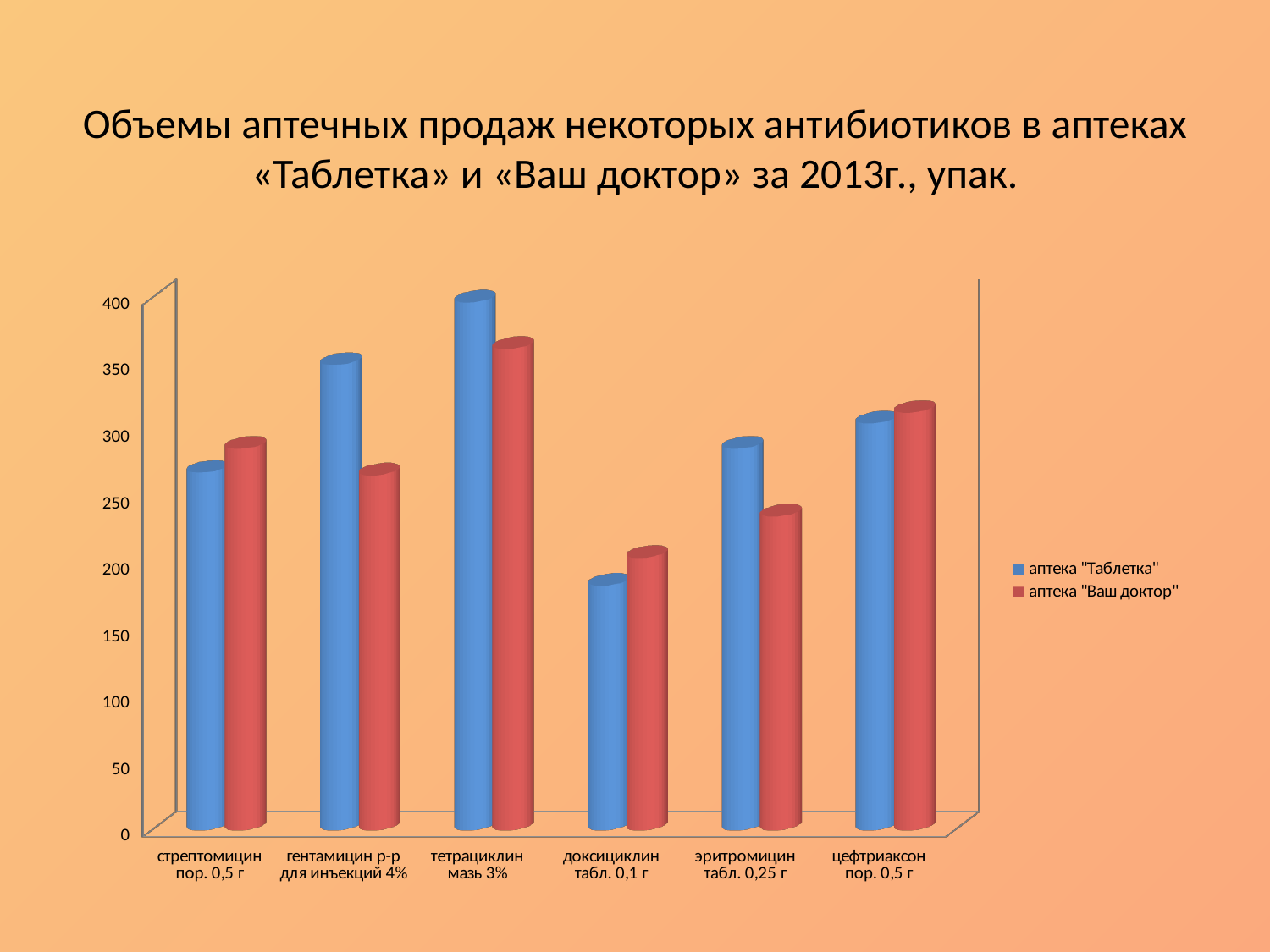
What kind of chart is shown on the slide? bar chart How many series does the legend list? 2 For which antibiotic is the value for аптека "Ваш доктор" the highest? тетрациклин мазь 3% For which antibiotic is the value for аптека "Таблетка" the highest? тетрациклин мазь 3% Which two pharmacies are listed in the legend? аптека "Таблетка" and аптека "Ваш доктор" For гентамицин р-р для инъекций 4%, which pharmacy has the larger value? аптека "Таблетка" Is the value for тетрациклин мазь 3% at аптека "Таблетка" greater or less than 350? greater For эритромицин табл. 0,25 г, which pharmacy has the larger value? аптека "Таблетка" For which antibiotic is the value for аптека "Ваш доктор" the lowest? доксициклин табл. 0,1 г For which antibiotic is the value for аптека "Таблетка" the lowest? доксициклин табл. 0,1 г How many antibiotic categories are shown on the x axis? 6 Is the value for доксициклин табл. 0,1 г at аптека "Таблетка" greater or less than 200? less